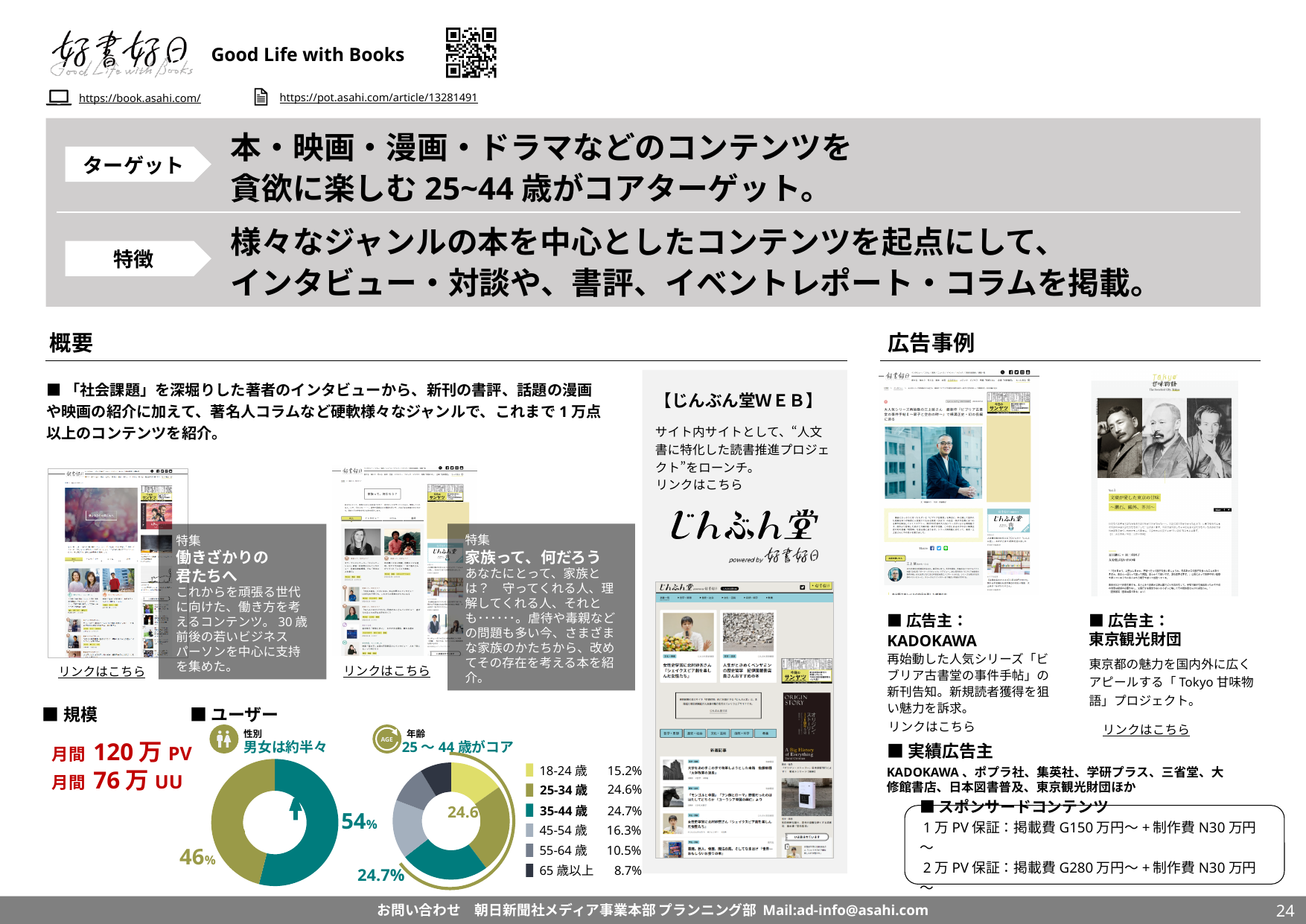
In the 年齢 (age) donut chart, what percentage is shown for 55-64 歳? 10.5% In the 性別 (gender) donut chart, what is the smaller of the two percentages shown? 46% In the 年齢 (age) donut chart, what percentage is shown for 18-24 歳? 15.2% In the 性別 (gender) donut chart, what is the difference between the two segments? 8 percentage points What kind of chart is used for the 年齢 (age) breakdown? Pie (donut) chart In the 年齢 (age) donut chart, which age group has the smallest share? 65 歳以上 What heading text is shown next to the AGE icon above the 年齢 donut chart? 25 ～ 44 歳がコア In the 年齢 (age) donut chart, which has the larger share, 45-54 歳 or 55-64 歳? 45-54 歳 In the 性別 (gender) donut chart, what is the larger of the two percentages shown? 54% In the 年齢 (age) donut chart, what percentage is shown for 35-44 歳? 24.7% In the 年齢 (age) donut chart, what is the difference between the 25-34 歳 share and the 18-24 歳 share? 9.4 percentage points How many age groups are listed in the 年齢 (age) donut chart? 6